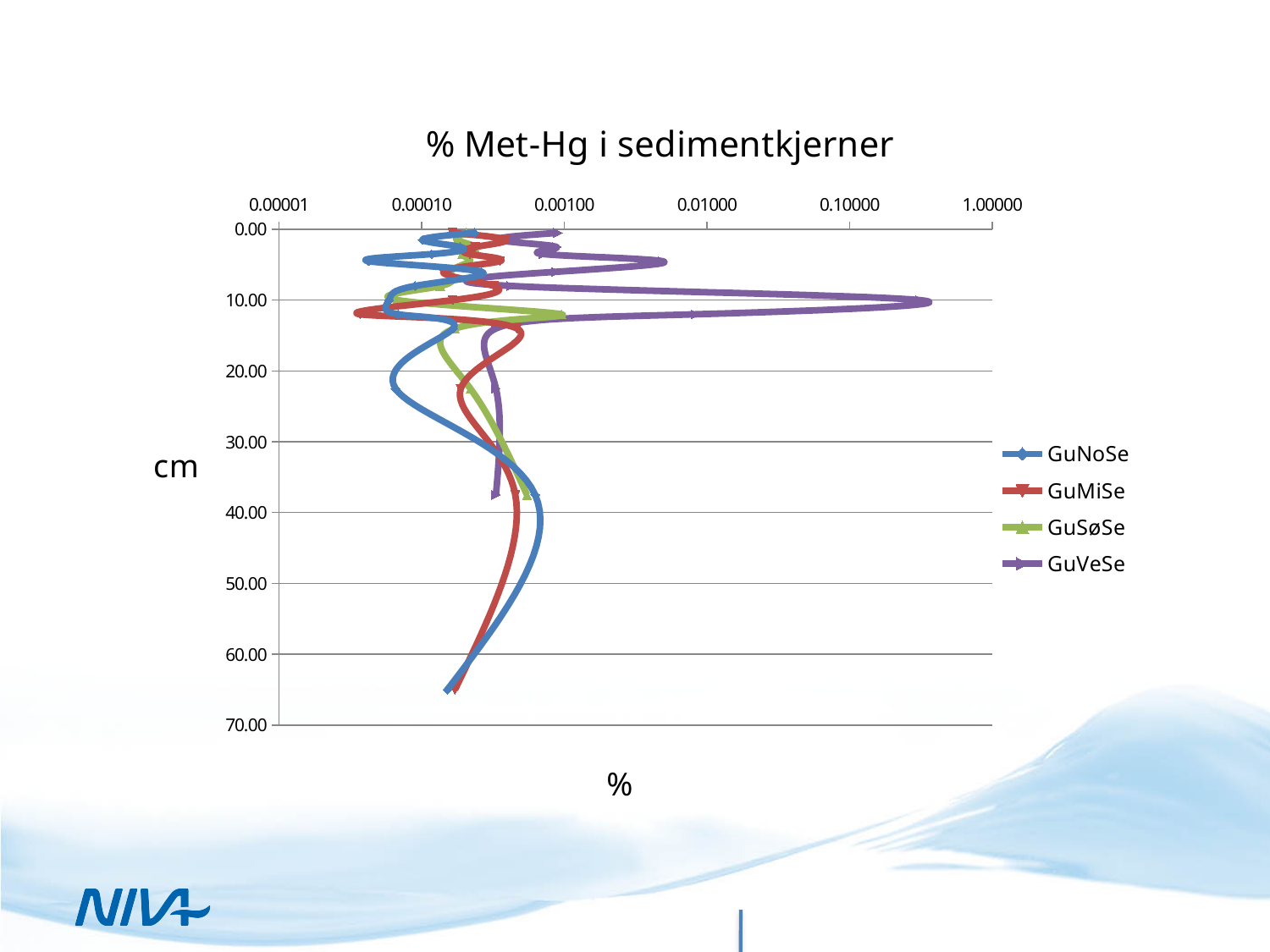
What is the label on the vertical axis of the chart? cm How many series does the chart legend list? 4 Is the peak value of the GuVeSe series greater or less than 0.10000? greater Is the peak value of the GuSøSe series greater or less than 0.01000? less What is the deepest depth tick shown on the vertical axis? 70.00 What is the largest value shown on the horizontal axis? 1.00000 What is the title of the chart? % Met-Hg i sedimentkjerner Does the GuVeSe series reach a greater or smaller peak value than the GuNoSe series? greater What is the smallest value shown on the horizontal axis? 0.00001 Which series reaches the highest % Met-Hg value in the chart? GuVeSe What kind of chart is shown on the slide? line chart Which series is drawn in purple in the chart? GuVeSe